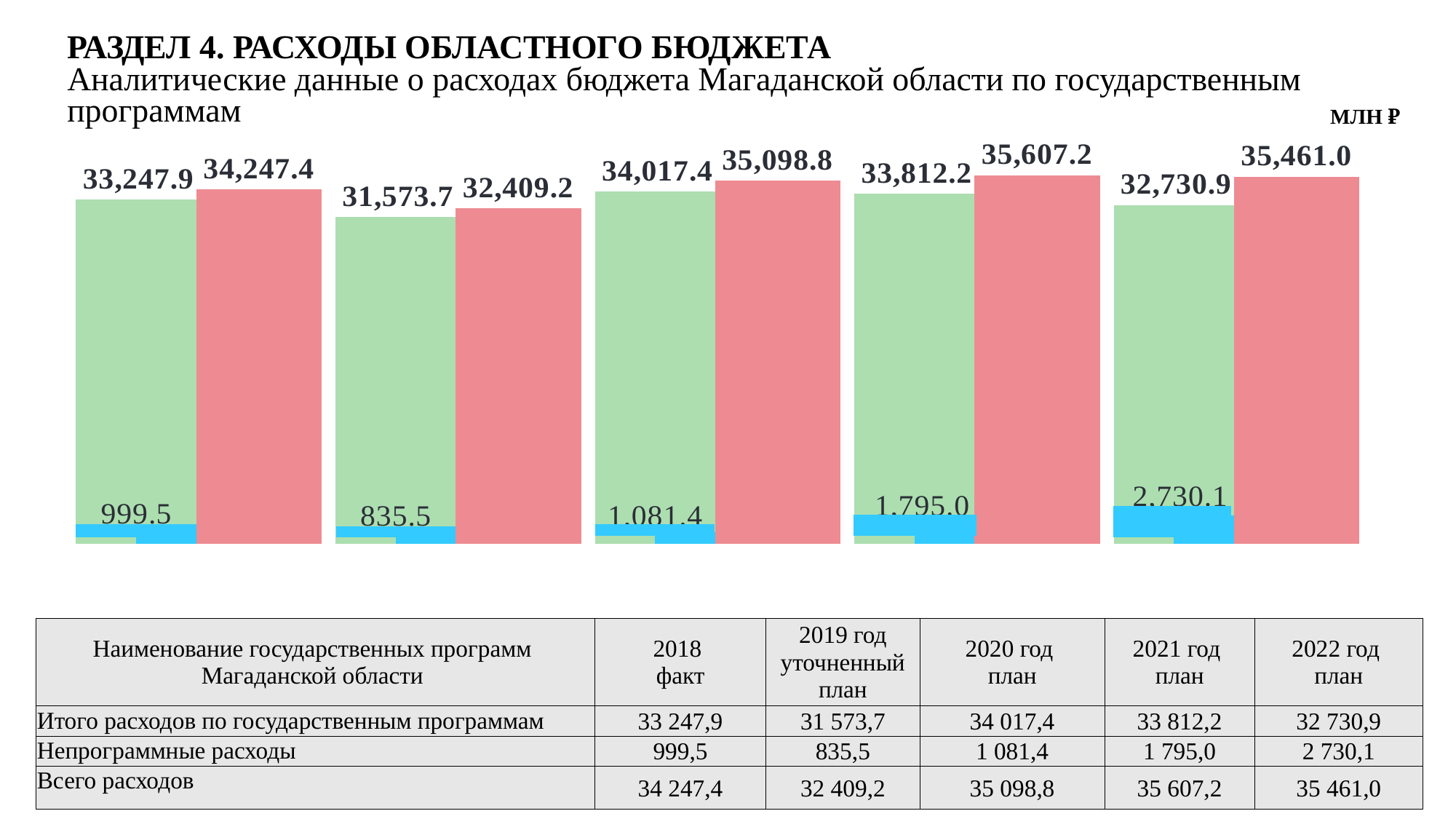
Which is larger: the green bar in the third group (34,017.4) or the green bar in the fourth group (33,812.2)? the third group (34,017.4) What is the value printed on the blue bar in the fifth (rightmost) group of bars? 2,730.1 What is the value printed above the green bar in the second group of bars? 31,573.7 Do the blue bar values rise or fall from the second group to the fifth group? rise What is the difference between the red bar and the green bar in the first group of bars? 999.5 What kind of chart is shown on the slide? bar chart What is the value printed above the red bar in the first group of bars? 34,247.4 Which group of bars has the highest red bar value? the fourth group (35,607.2) How many groups of bars does the chart contain? 5 What unit is indicated for the chart values in the top right corner? млн ₽ Which group of bars has the lowest blue bar value? the second group (835.5) Which group of bars has the lowest green bar value? the second group (31,573.7)